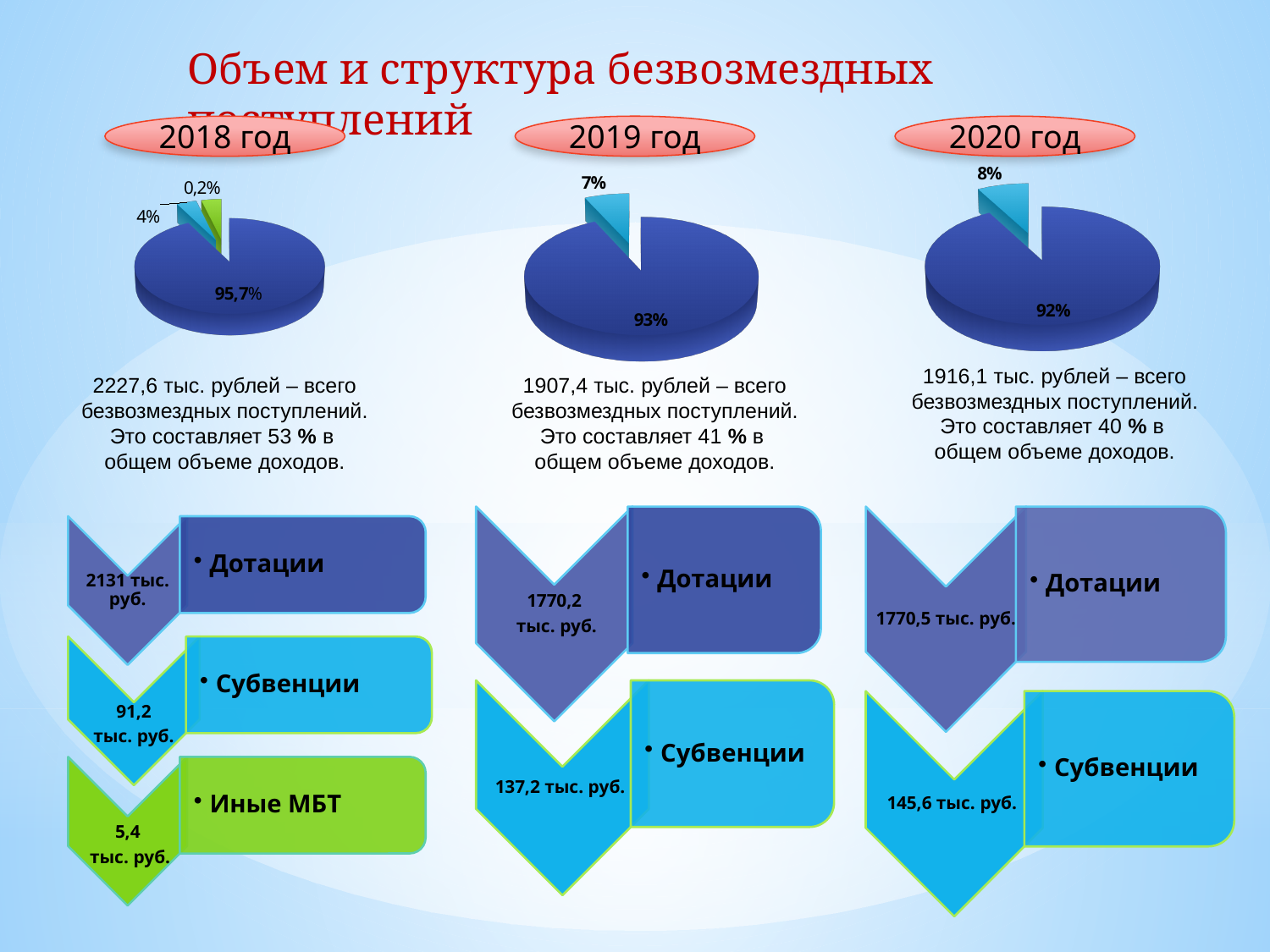
In the 2020 год pie chart, what is the value of the largest slice? 92% In the 2019 год pie chart, what is the value of the largest slice? 93% In the 2018 год pie chart, what is the value of the largest slice? 95,7% Which pie chart has the larger smaller slice, 2019 год or 2020 год? 2020 год In the 2019 год pie chart, what is the value of the smaller slice? 7% What is the title of the slide containing the three pie charts? Объем и структура безвозмездных поступлений How many slices does the 2019 год pie chart have? 2 In the 2020 год pie chart, what is the value of the smaller slice? 8% How many slices does the 2018 год pie chart have? 3 In the 2018 год pie chart, what is the value of the smallest slice? 0,2% What is the difference between the largest slice of the 2019 год pie chart and the largest slice of the 2020 год pie chart? 1% What kind of chart is used for the 2018 год chart? pie chart